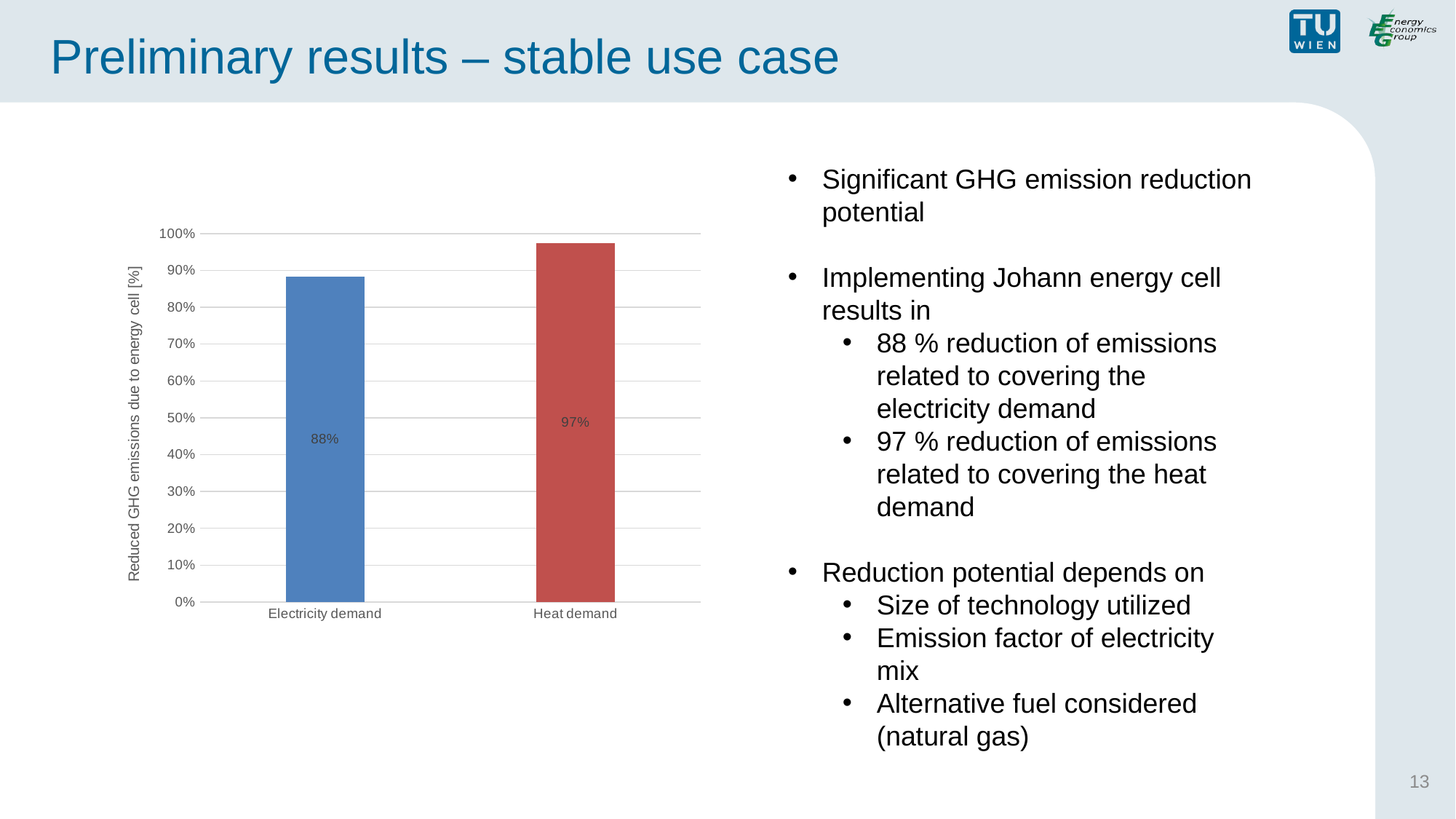
Is the value for Electricity demand greater or less than 90%? less What is the difference between the values for Heat demand and Electricity demand? 9% Which category has the highest value? Heat demand What is the value for Heat demand? 97% How many categories are shown on the x axis? 2 What is the label of the y axis? Reduced GHG emissions due to energy cell [%] Is the value for Heat demand greater or less than 90%? greater Which category has the lowest value? Electricity demand What is the value for Electricity demand? 88% What colour is the bar for Heat demand? Red Which is larger, the value for Electricity demand or the value for Heat demand? Heat demand What kind of chart is shown? Bar chart